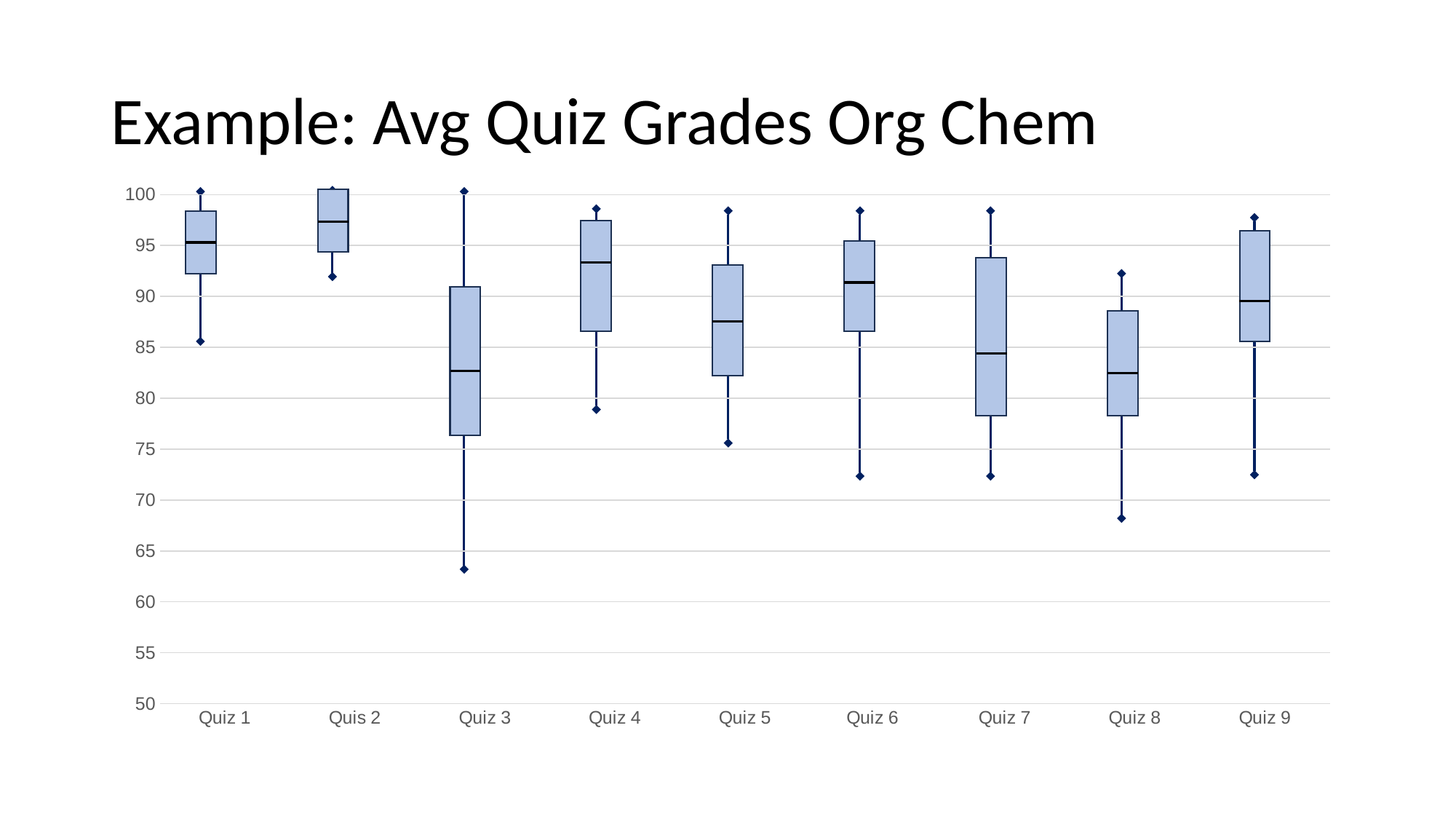
What is the lowest value shown on the y axis? 50 Is the lowest whisker value for Quiz 3 greater or less than 65? less What kind of chart is shown on the slide? Box-and-whisker chart Is the lowest whisker value for Quiz 6 greater or less than 75? less Which quiz has the lowest minimum value (lowest whisker end)? Quiz 3 How many quizzes are plotted along the x axis? 9 Is the median for Quiz 3 greater or less than 85? less Which has the larger median, Quiz 1 or Quiz 5? Quiz 1 What is the title of the slide containing the chart? Example: Avg Quiz Grades Org Chem Which quiz has the highest median line? Quis 2